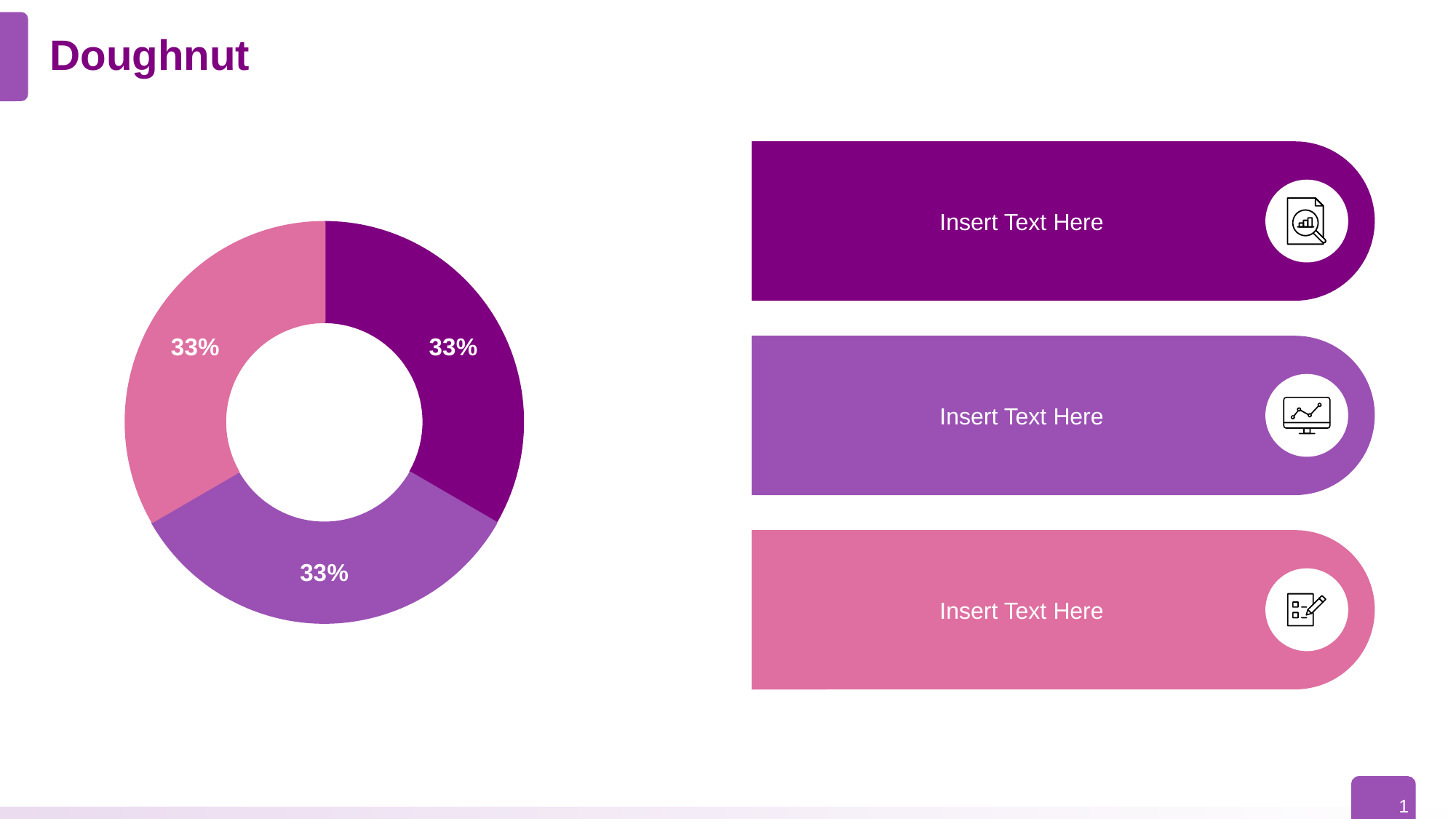
What is the title of the slide containing the doughnut chart? Doughnut What percentage is shown on the pink slice of the doughnut chart? 33% What percentage is shown on the dark purple slice of the doughnut chart? 33% Are the three slices of the doughnut chart labelled with the same percentage? yes What is the difference between the value of the dark purple slice and the pink slice? 0% How many slices does the doughnut chart have? 3 What percentage is shown on the medium purple slice at the bottom of the doughnut chart? 33% Is the value of the dark purple slice greater or less than 50%? less What share of the doughnut does the pink slice represent? 33% What kind of chart is shown on the slide? doughnut chart Does the doughnut chart have a legend? no Is the value of the pink slice greater or less than 25%? greater